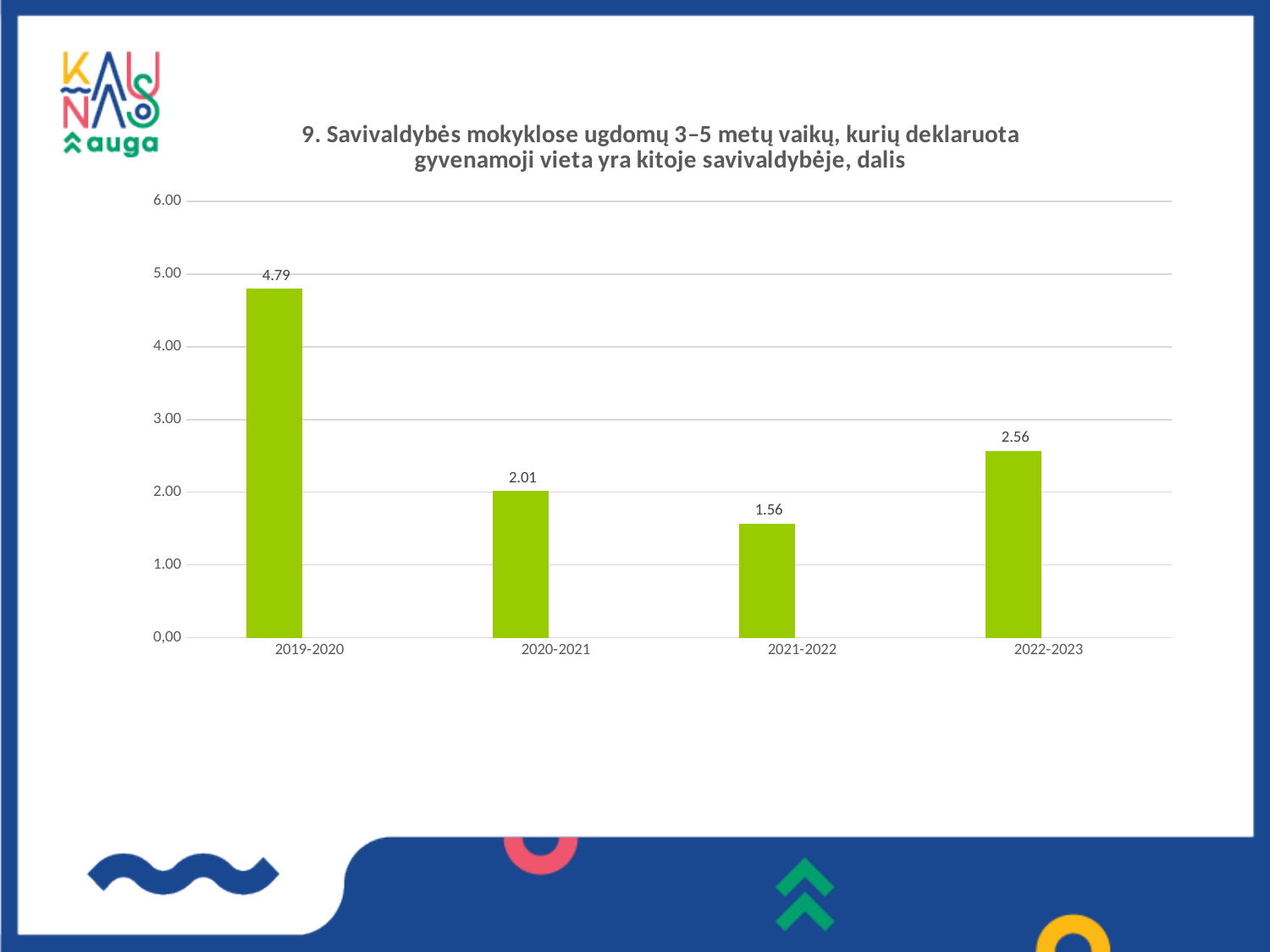
What is the value for 2022-2023? 2.56 Which school year has the lowest value? 2021-2022 What is the value for 2021-2022? 1.56 What kind of chart is shown on the slide? bar chart Which is larger, the value for 2020-2021 or the value for 2022-2023? 2022-2023 What is the value for 2019-2020? 4.79 Which school year has the highest value? 2019-2020 How many school years are shown on the x axis? 4 What colour are the bars in the chart? green Is the value for 2019-2020 greater or less than 4.00? greater What is the difference between the values for 2019-2020 and 2022-2023? 2.23 What is the value for 2020-2021? 2.01